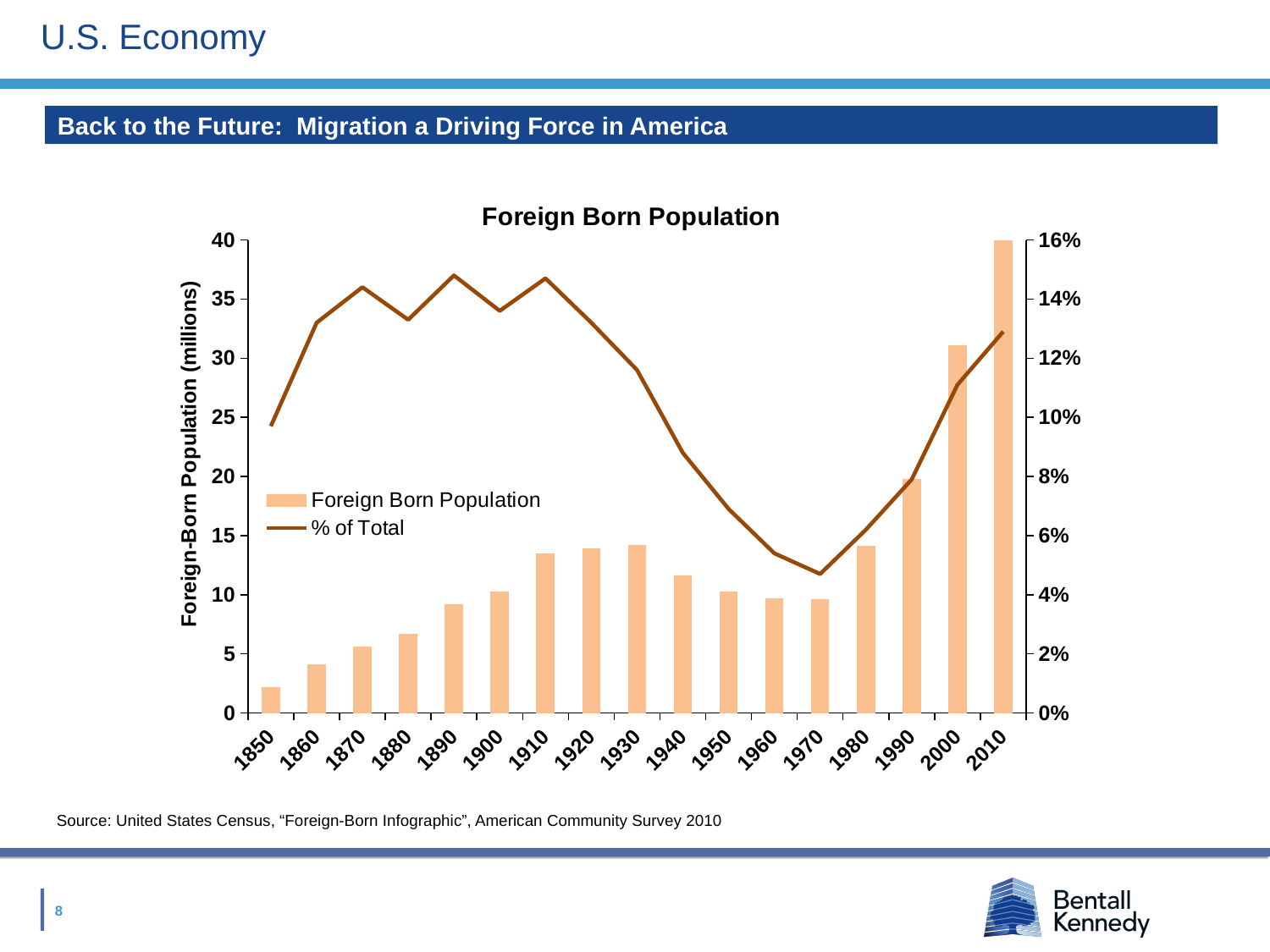
Which year has the larger Foreign Born Population bar, 1930 or 1940? 1930 In which year does the % of Total line reach its lowest point? 1970 Which year has the shortest Foreign Born Population bar? 1850 How many series does the legend of the Foreign Born Population chart list? 2 Is the % of Total value for 1970 greater or less than 6%? less What is the label on the left vertical axis of the chart? Foreign-Born Population (millions) Do the Foreign Born Population bars rise or fall from 1970 to 2010? rise What kind of chart is shown on the slide? A combined bar and line chart How many years are shown along the x axis of the Foreign Born Population chart? 17 Is the Foreign Born Population bar for 2000 greater or less than 30 million? greater Which year has the tallest Foreign Born Population bar? 2010